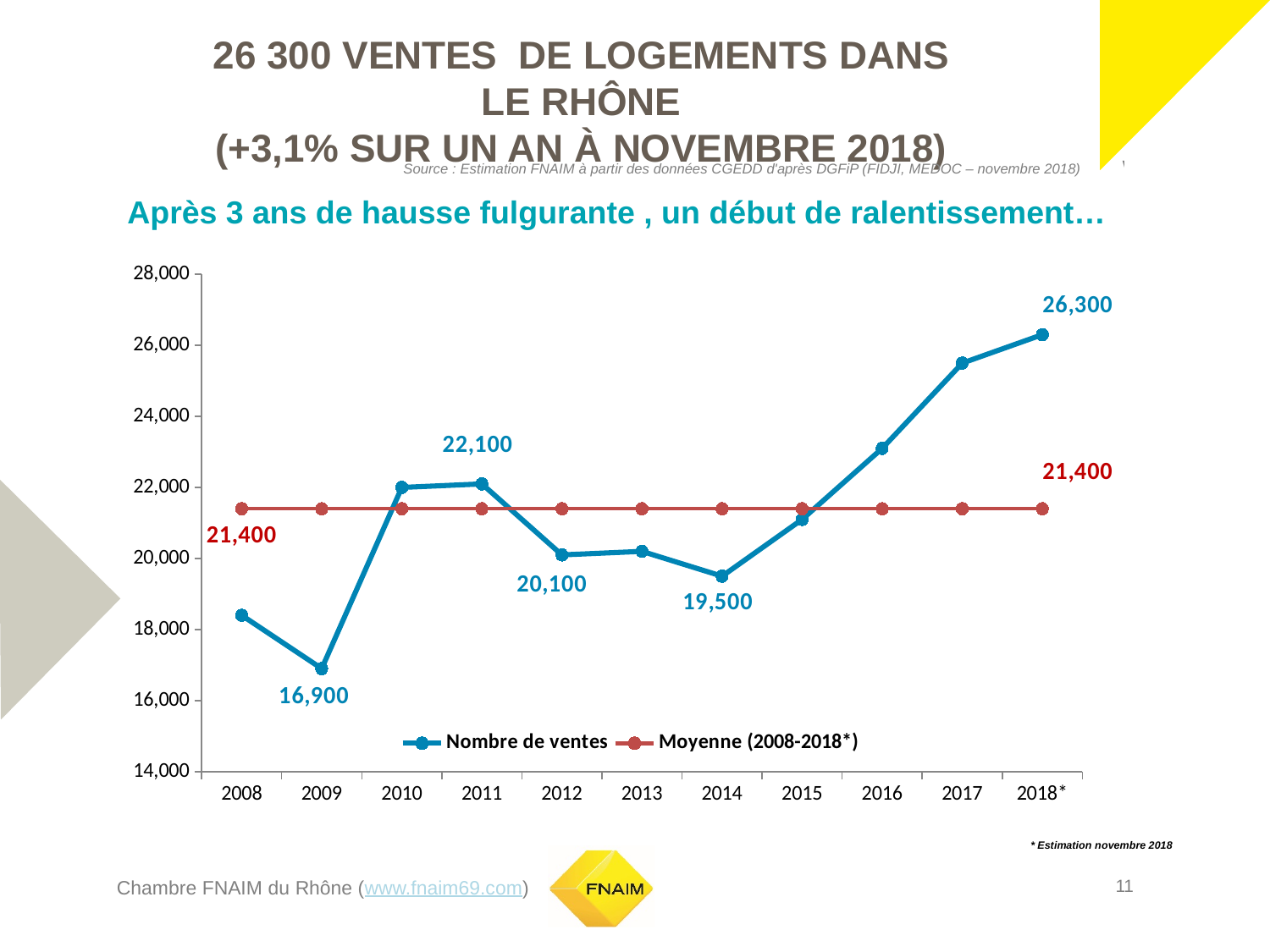
What is the value of Nombre de ventes for 2014? 19,500 What is the value of Nombre de ventes for 2009? 16,900 Is the value of Nombre de ventes for 2017 greater or less than 24,000? greater What is the value of Nombre de ventes for 2018*? 26,300 What is the difference between Nombre de ventes in 2011 and in 2012? 2,000 What is the difference between Nombre de ventes in 2018* and in 2009? 9,400 In which year is Nombre de ventes highest? 2018* How many years are shown on the x axis? 11 In which year is Nombre de ventes lowest? 2009 What is the value of the Moyenne (2008-2018*) line? 21,400 Is the value of Nombre de ventes for 2008 greater or less than 20,000? less How many series does the legend list? 2